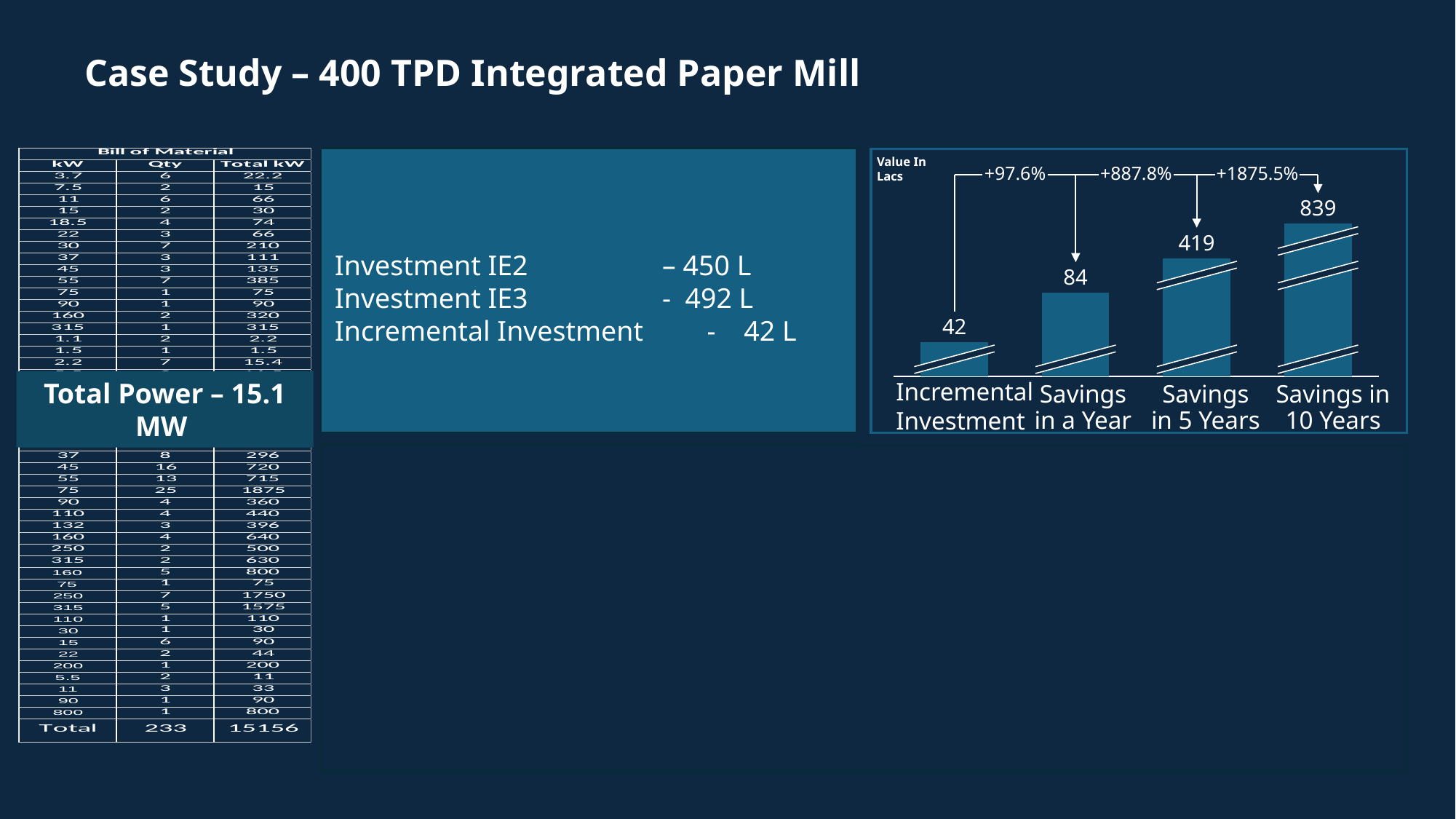
What is the value for Savings in a Year? 84 What is the value for Savings in 5 Years? 419 Which is larger, Savings in 5 Years or Savings in a Year? Savings in 5 Years What is the difference between Savings in a Year and Incremental Investment? 42 How many categories are shown in the chart? 4 What percentage increase is annotated between Savings in 5 Years and Savings in 10 Years? +1875.5% What kind of chart is shown? Bar chart Which category has the lowest value? Incremental Investment What is the value for Incremental Investment? 42 What is the difference between Savings in 10 Years and Savings in 5 Years? 420 What is the value for Savings in 10 Years? 839 Which category has the highest value? Savings in 10 Years